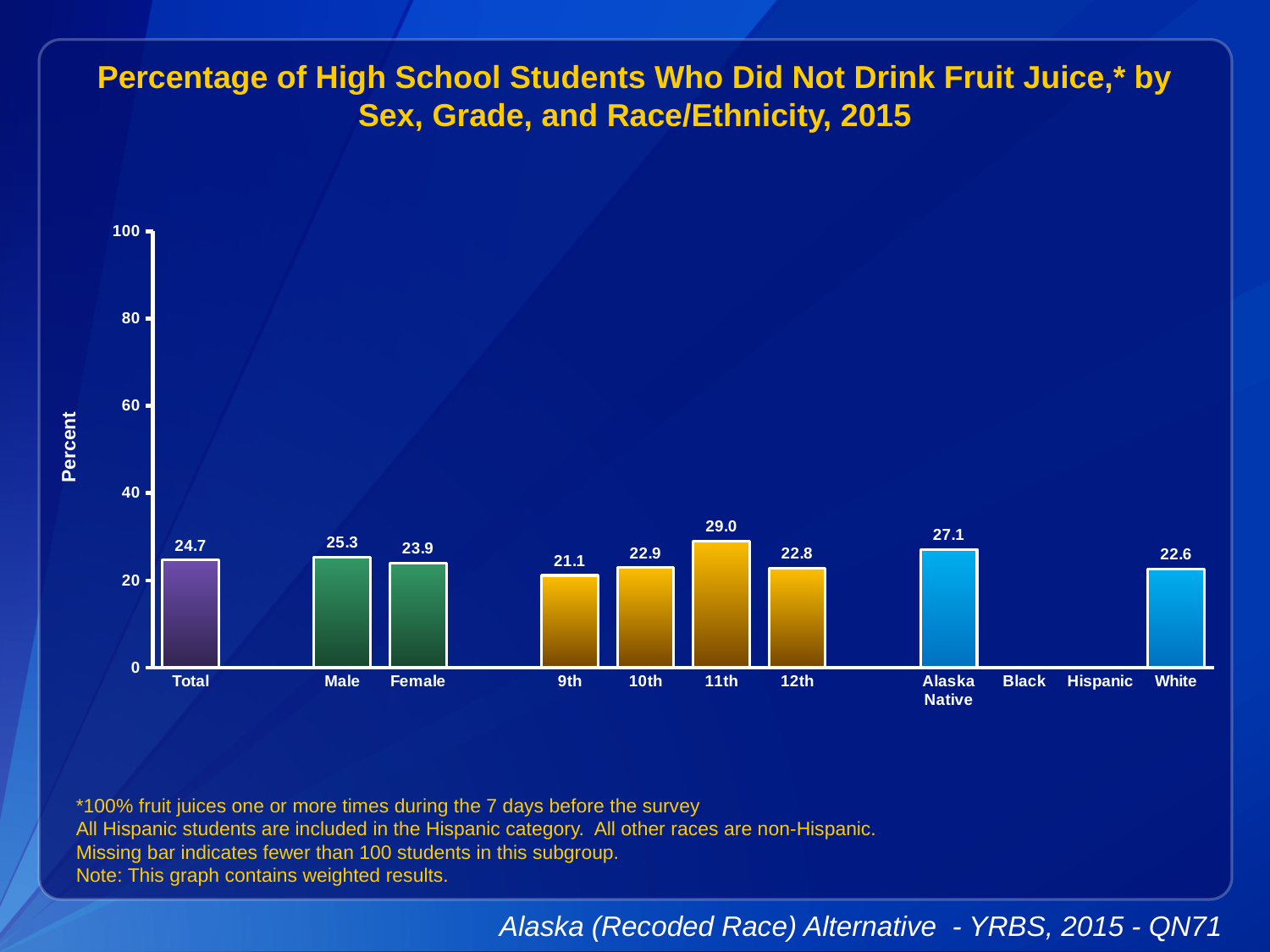
What is the value for Alaska Native students? 27.1 How many categories have a bar plotted on the chart? 9 Which category has the highest value? 11th Is the value for White students greater or less than 40? less What kind of chart is shown? bar chart Which is larger, the value for 10th grade or the value for 12th grade? 10th Which category has the lowest value among the bars shown? 9th What is the value for Total? 24.7 What is the value for 11th grade students? 29.0 What is the difference between the values for Male and Female? 1.4 What is the label on the y axis? Percent Which categories have no bar shown? Black and Hispanic